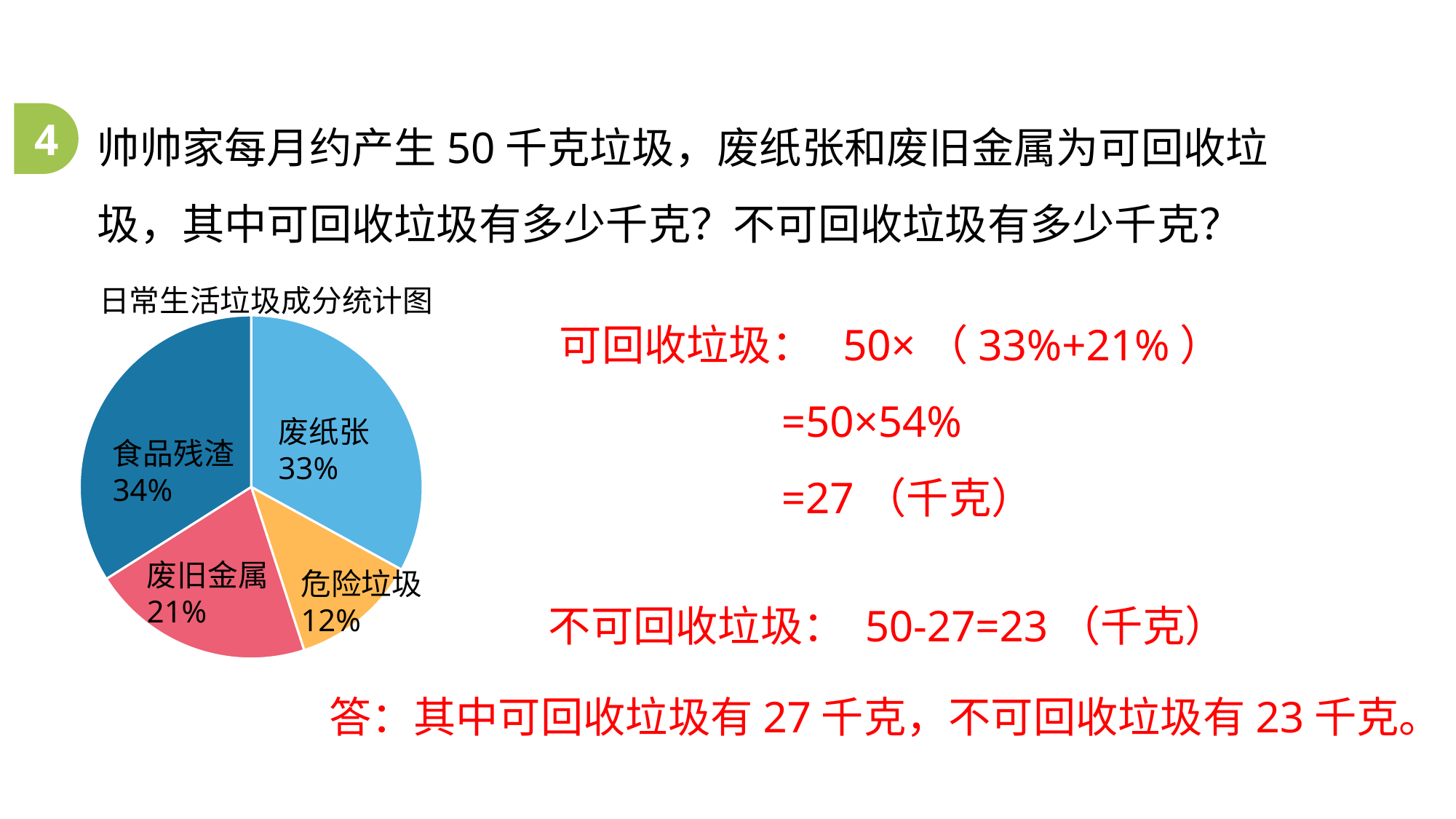
What is the combined share of 废纸张 and 废旧金属? 54% What percentage does 食品残渣 account for in the pie chart? 34% What is the difference in percentage points between 食品残渣 and 危险垃圾? 22 Which category has the largest share of the pie chart? 食品残渣 What percentage does 危险垃圾 account for in the pie chart? 12% What percentage does 废纸张 account for in the pie chart? 33% What percentage does 废旧金属 account for in the pie chart? 21% What is the title of the chart? 日常生活垃圾成分统计图 Which is larger, the share of 废旧金属 or the share of 危险垃圾? 废旧金属 How many slices does the pie chart have? 4 What type of chart is shown on the slide? pie chart Which category has the smallest share of the pie chart? 危险垃圾